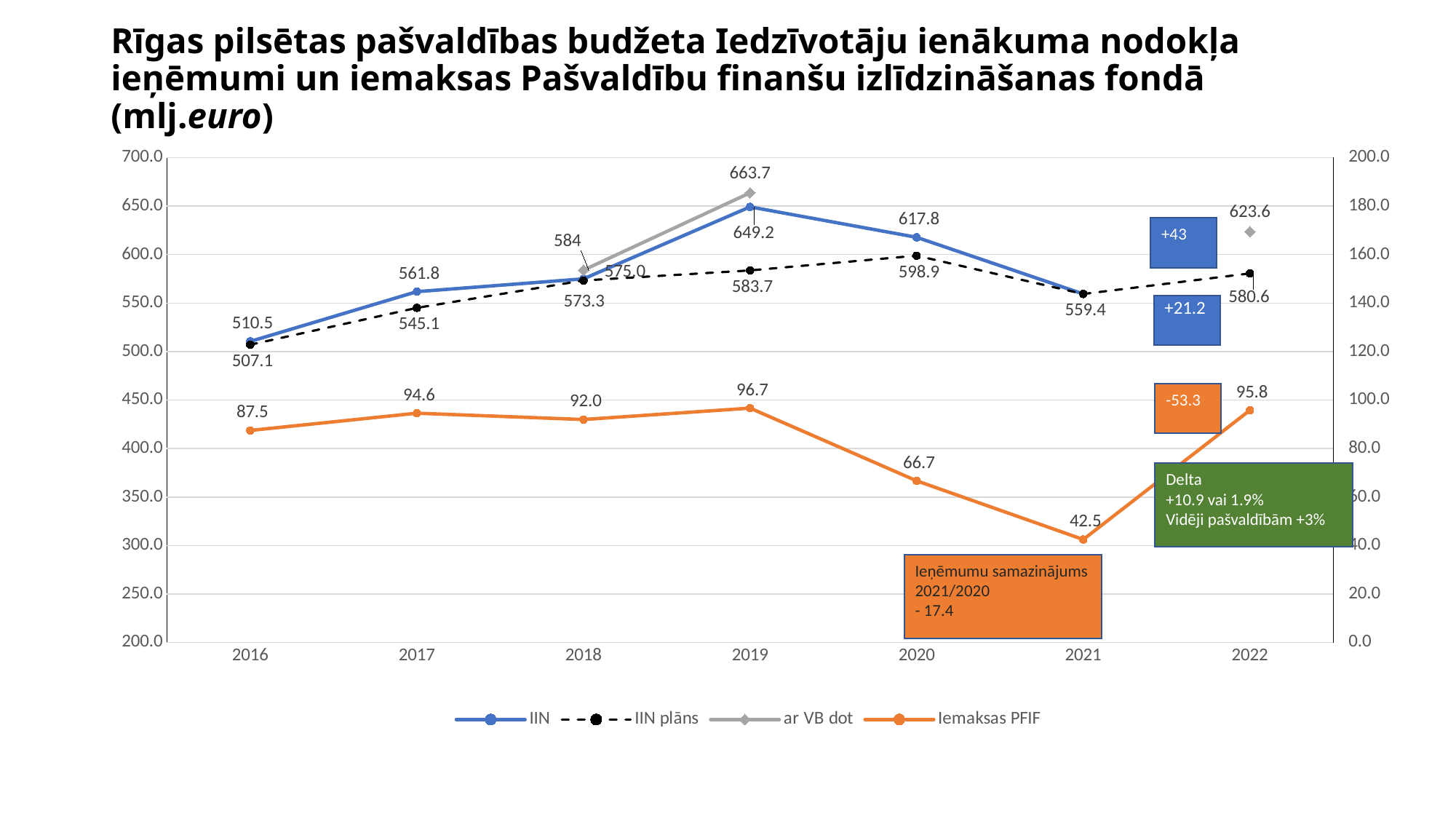
What is the ar VB dot value for 2019? 663.7 What is the IIN plāns value for 2022? 580.6 How many series does the legend list? 4 What kind of chart is shown on the slide? line chart How many years are shown on the x axis? 7 In which year is the IIN series highest? 2019 In which year is the Iemaksas PFIF series lowest? 2021 What is the difference between IIN and IIN plāns in 2019? 65.5 In 2020, which is larger: IIN or IIN plāns? IIN What is the IIN value for 2019? 649.2 What is the Iemaksas PFIF value for 2021? 42.5 Does the Iemaksas PFIF series rise or fall from 2019 to 2021? fall